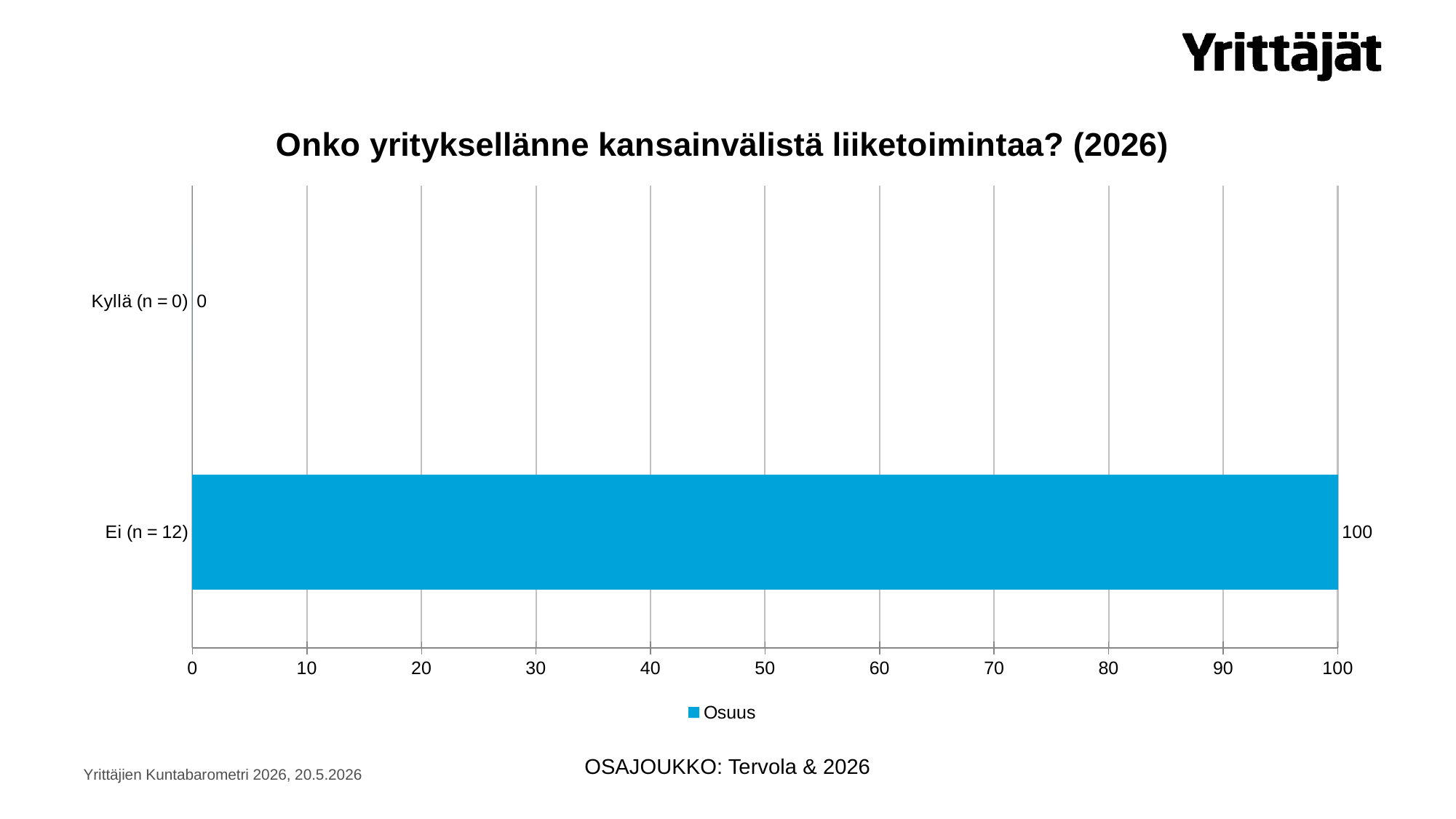
Which category has the highest value? Ei (n = 12) What is the title of the chart? Onko yrityksellänne kansainvälistä liiketoimintaa? (2026) What kind of chart is shown on the slide? bar chart Is the value for Ei (n = 12) greater or less than 50? greater What is the value for Kyllä (n = 0)? 0 Which is larger, the value for Ei (n = 12) or the value for Kyllä (n = 0)? Ei (n = 12) What is the name of the series shown in the legend? Osuus How many categories are shown in the chart? 2 How many series does the legend list? 1 Which category has the lowest value? Kyllä (n = 0) What is the difference between the values for Ei (n = 12) and Kyllä (n = 0)? 100 What is the value for Ei (n = 12)? 100